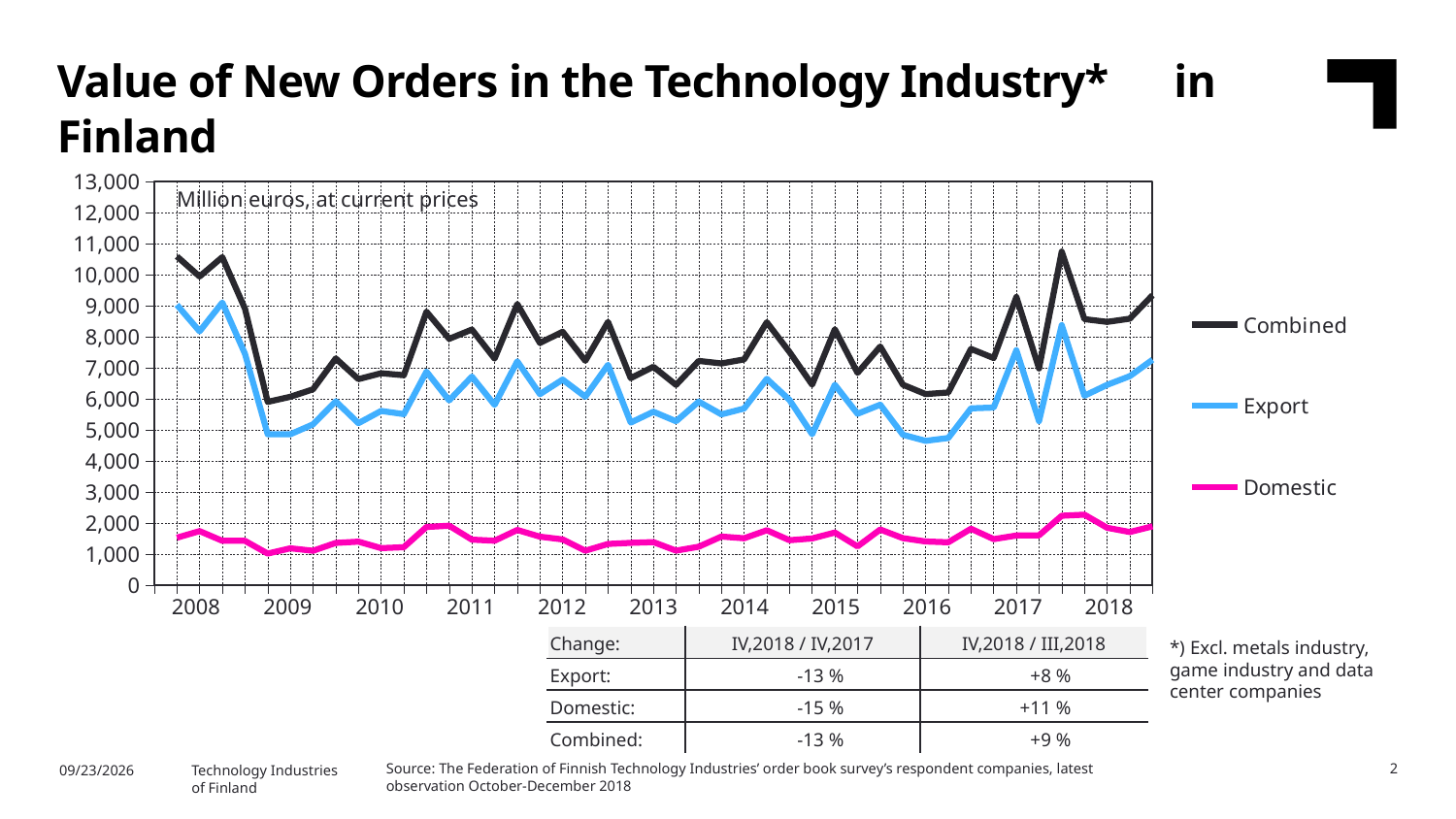
Is the Domestic value at the end of 2018 greater or less than 3,000? less Is the peak Combined value in 2017 greater or less than 10,000? greater Is the Export value at the start of 2008 greater or less than 8,000? greater Which series is shown in pink in the chart? Domestic Which series has the lowest values throughout the chart? Domestic Which is larger in 2018, the Export value or the Domestic value? Export How many years are labelled on the x axis of the chart? 11 What unit does the chart say the values are in? Million euros, at current prices What kind of chart is shown on the slide? line chart Which series has the highest values throughout the chart? Combined How many series does the chart's legend list? 3